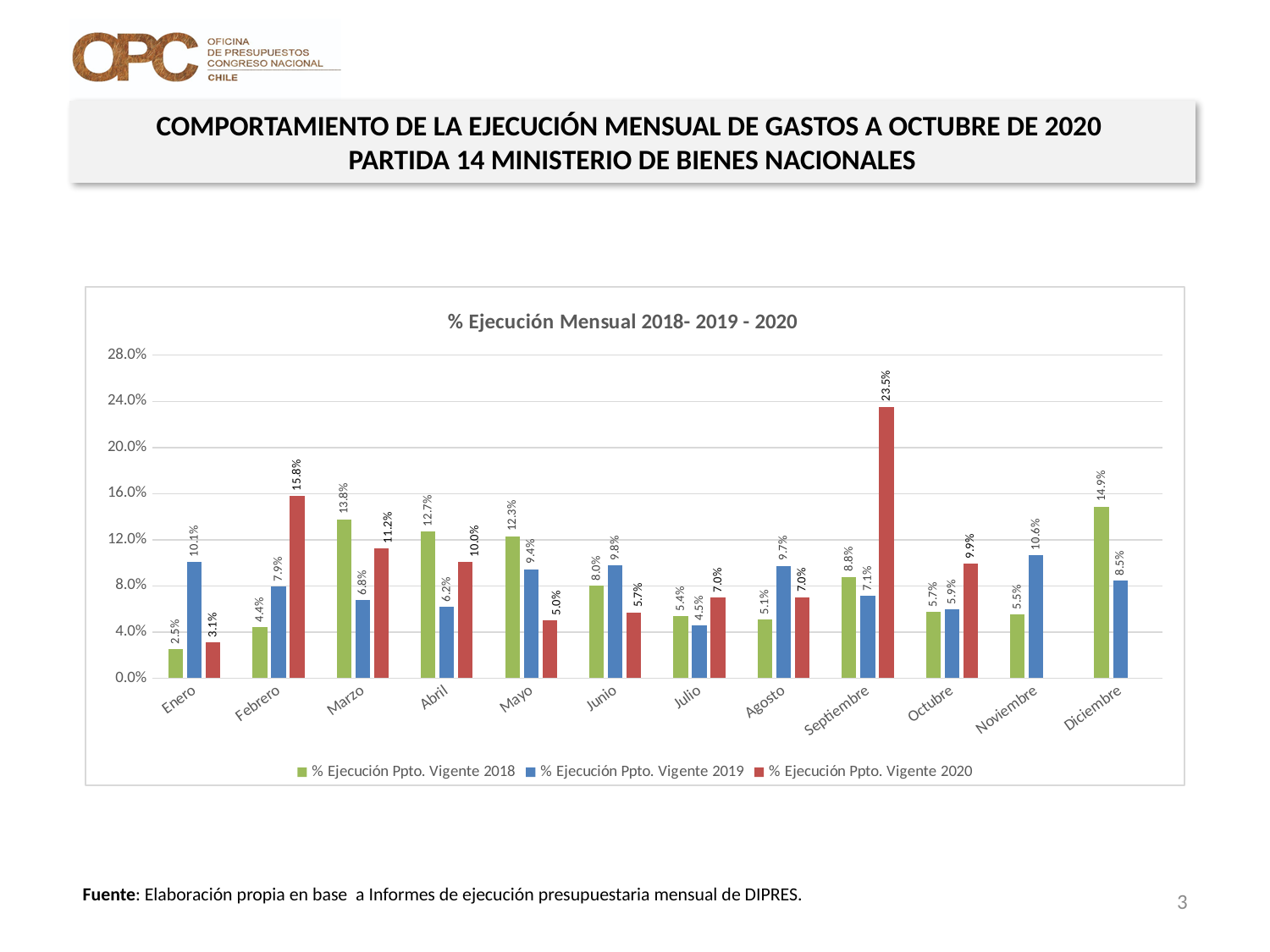
Which months have no bar for % Ejecución Ppto. Vigente 2020? Noviembre and Diciembre How many months are shown on the x axis? 12 What is the value for % Ejecución Ppto. Vigente 2018 in Marzo? 13.8% What is the value for % Ejecución Ppto. Vigente 2020 in Septiembre? 23.5% What kind of chart is shown on the slide? Bar chart What is the title of the chart? % Ejecución Mensual 2018- 2019 - 2020 What is the value for % Ejecución Ppto. Vigente 2019 in Noviembre? 10.6% What is the difference between the 2020 and 2018 values in Febrero? 11.4% Which is larger in Mayo: the 2018 value or the 2019 value? 2018 (12.3%) Which month has the lowest value for % Ejecución Ppto. Vigente 2018? Enero How many series does the legend list? 3 Which month has the highest value for % Ejecución Ppto. Vigente 2020? Septiembre